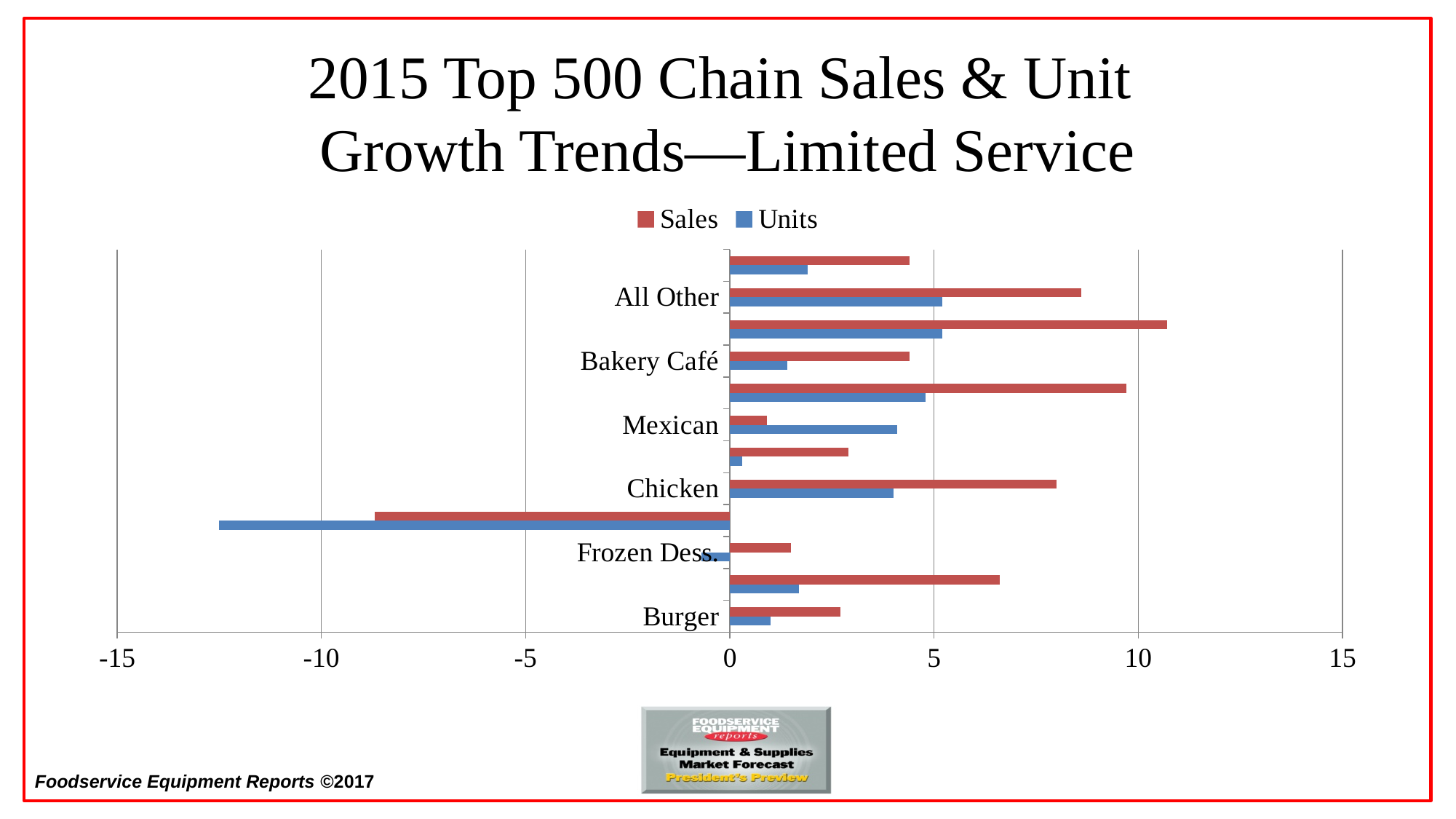
Is the Sales value for Burger greater or less than 5? less How many series does the legend list? 2 Which colour represents the Sales series in the legend? red Is the Units value for Chicken greater or less than 5? less For Chicken, which is larger, the Sales value or the Units value? Sales For Mexican, which is larger, the Sales value or the Units value? Units Is the Sales value for Chicken greater or less than 5? greater What kind of chart is shown on the slide? bar chart For All Other, which is larger, the Sales value or the Units value? Sales